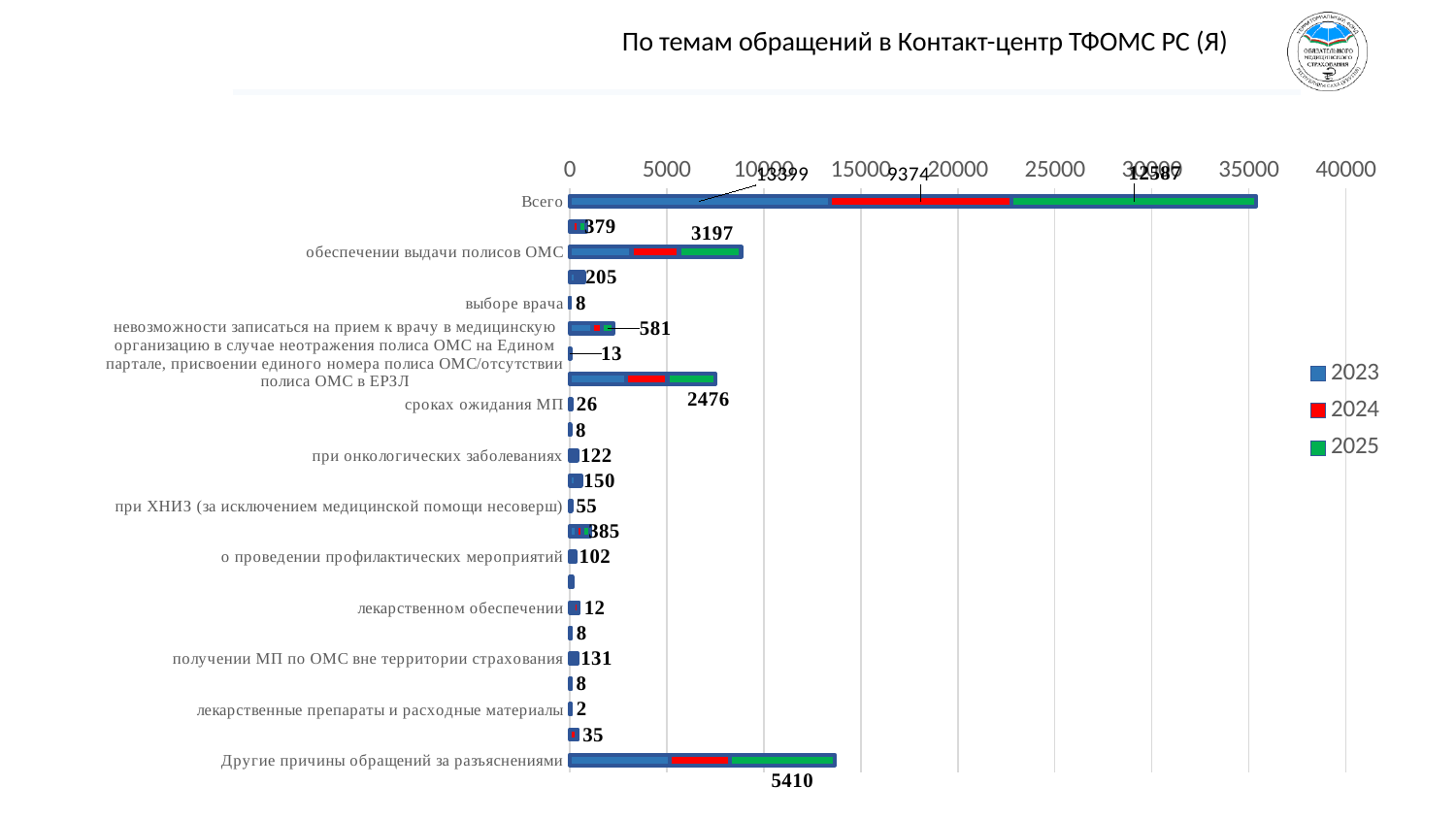
What is the 2023 value for the category Всего? 13399 Which category has the longest bar in the chart? Всего What is the 2024 value for the category Всего? 9374 How many series does the legend list? 3 What type of chart is shown on the slide? bar chart What is the difference between the 2023 value and the 2024 value for the category Всего? 4025 What data label is shown for the category выборе врача? 8 What is the title of the chart? По темам обращений в Контакт-центр ТФОМС РС (Я) What are the legend entries of the chart? 2023, 2024, 2025 Is the total bar length for Другие причины обращений за разъяснениями greater or less than 10000? greater Is the total bar length for Всего greater or less than 30000? greater For the category Всего, which is larger: the 2023 value or the 2024 value? 2023